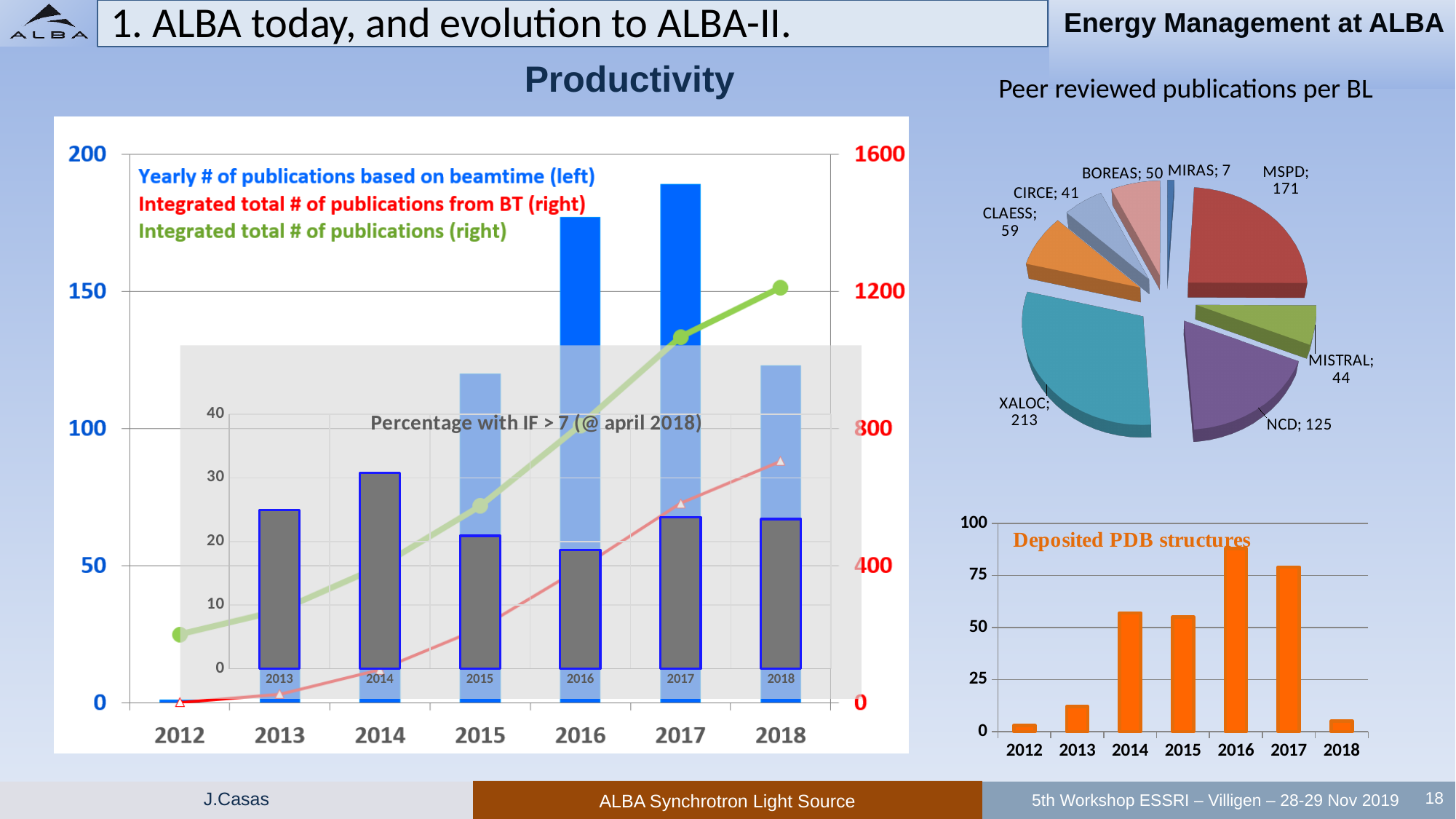
In the 'Peer reviewed publications per BL' pie chart, how many beamlines are shown? 8 In the 'Deposited PDB structures' chart, is the value for 2014 greater or less than 50? greater In the 'Peer reviewed publications per BL' pie chart, which is larger, CLAESS or BOREAS? CLAESS In the 'Peer reviewed publications per BL' pie chart, which beamline has the largest slice? XALOC In the 'Deposited PDB structures' chart, which year has the highest bar? 2016 In the 'Peer reviewed publications per BL' pie chart, how many publications does XALOC have? 213 In the 'Peer reviewed publications per BL' pie chart, what share of the total does XALOC represent? 30% In the 'Peer reviewed publications per BL' pie chart, which beamline has the smallest slice? MIRAS In the 'Deposited PDB structures' chart, is the value for 2018 greater or less than 25? less How many series does the legend of the 'Productivity' chart list? 3 In the 'Peer reviewed publications per BL' pie chart, what is the difference between the MSPD and NCD values? 46 In the 'Productivity' chart, which year has the highest yearly number of publications based on beamtime? 2017